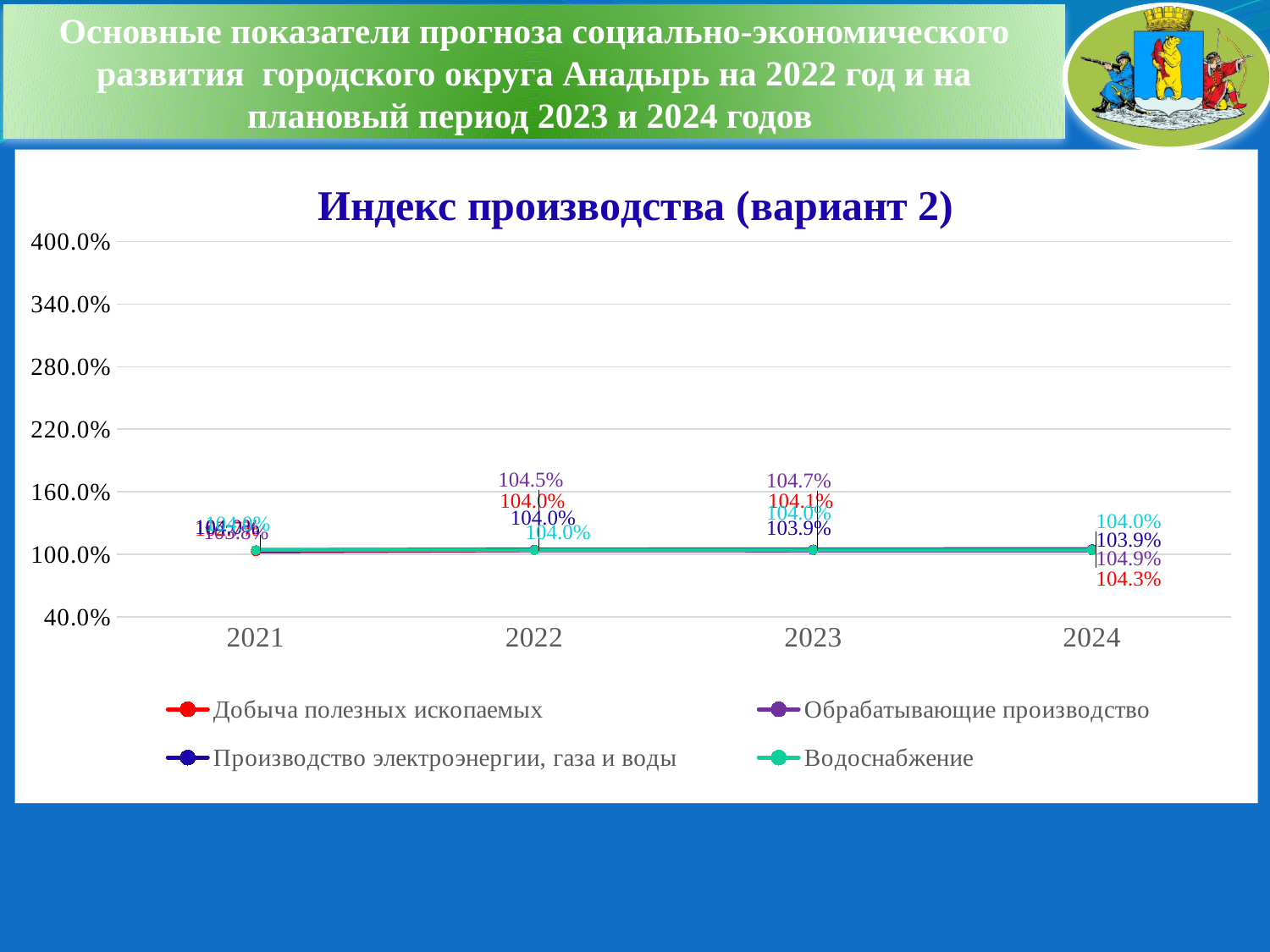
What is the value for Обрабатывающие производство in 2024? 104.9% What is the value for Добыча полезных ископаемых in 2024? 104.3% Does the value for Обрабатывающие производство rise or fall from 2022 to 2024? rise How many years are shown on the x axis? 4 Which series has the highest value in 2024? Обрабатывающие производство How many series does the legend list? 4 What is the value for Обрабатывающие производство in 2022? 104.5% What is the difference between the Обрабатывающие производство values in 2024 and 2022? 0.4% What is the value for Обрабатывающие производство in 2023? 104.7% What is the value for Добыча полезных ископаемых in 2023? 104.1% What kind of chart is shown on the slide? line chart What is the title of the chart? Индекс производства (вариант 2)